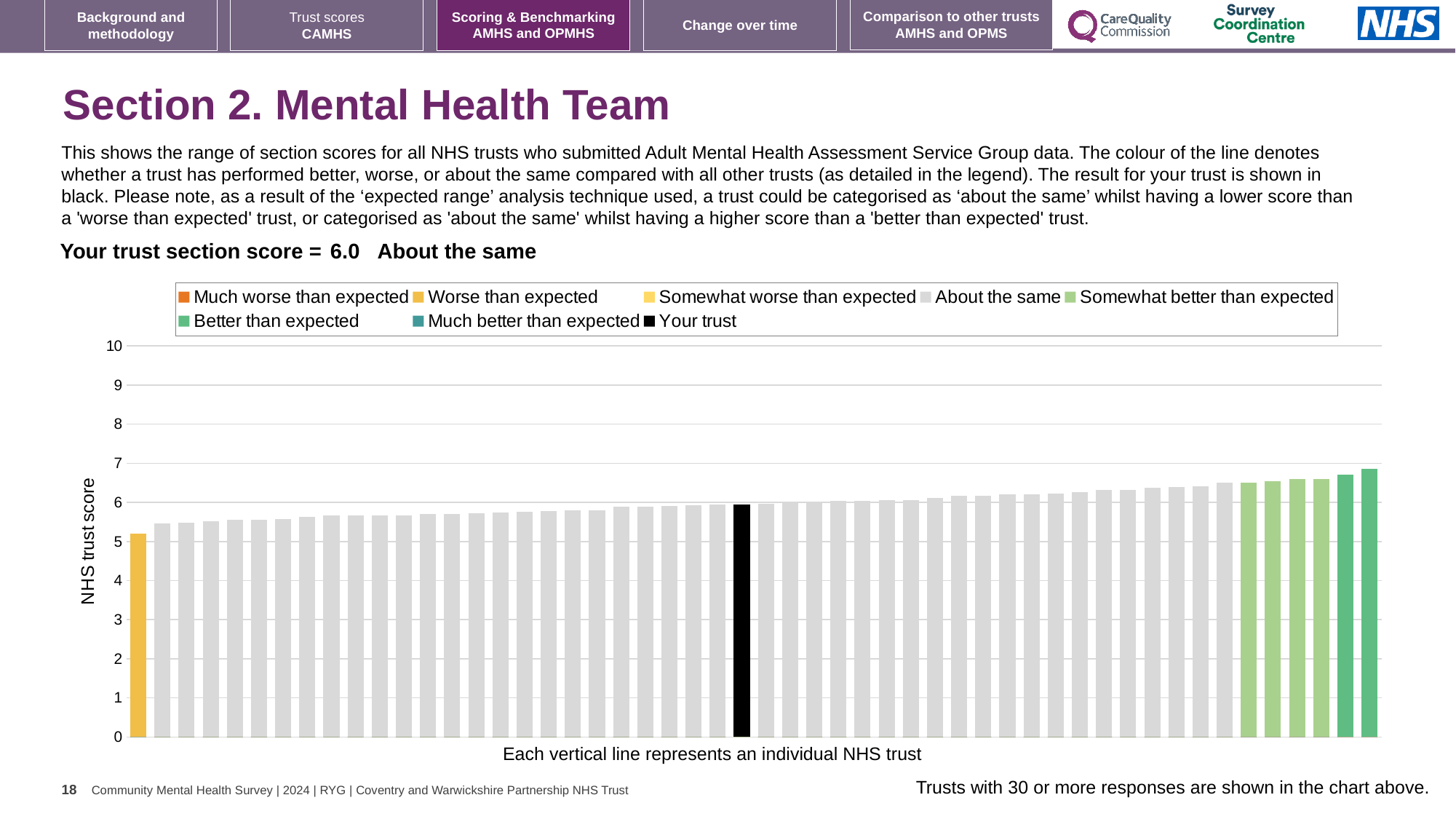
Is the value of the black 'Your trust' bar greater or less than 5? greater Is the value of the leftmost (lowest) bar greater or less than 5? greater What is the section score for your trust shown on the slide? 6.0 Do the bar values rise or fall from left to right along the x axis? rise Is the value of the rightmost (highest) bar greater or less than 7? less What kind of chart is shown on the slide? bar chart According to the legend, which category does the black bar represent? Your trust How many entries does the chart legend list? 8 Which is larger, the rightmost bar or the black 'Your trust' bar? the rightmost bar What is the label on the vertical axis of the chart? NHS trust score